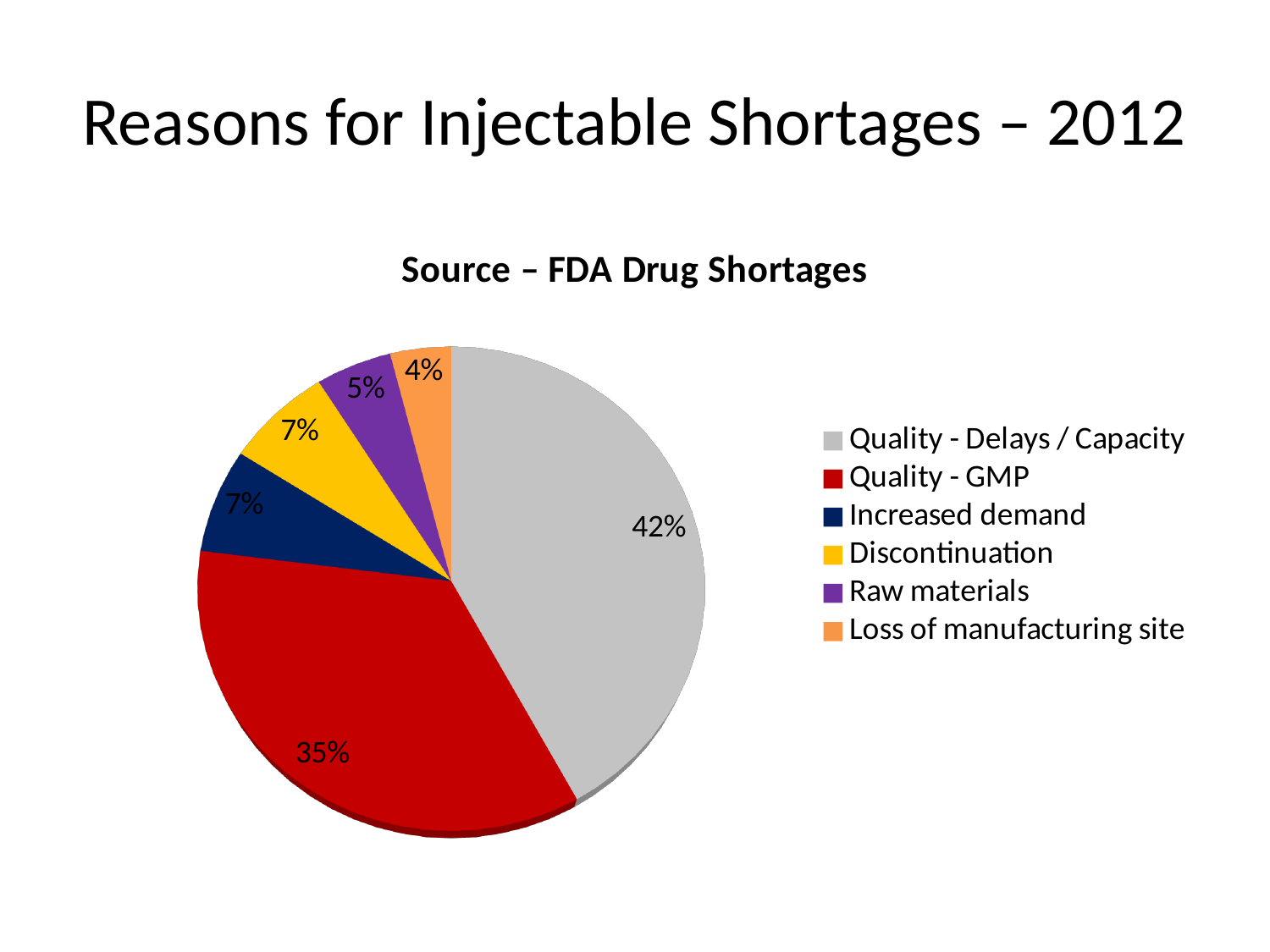
What share of the pie does Raw materials represent? 5% What share of the pie does Quality - Delays / Capacity represent? 42% What is the difference in percentage points between Quality - Delays / Capacity and Quality - GMP? 7 What is the title of the chart? Source – FDA Drug Shortages What colour is the slice for Increased demand? dark blue Which category has the smallest slice of the pie? Loss of manufacturing site Which is larger, the slice for Raw materials or the slice for Discontinuation? Discontinuation What share of the pie does Quality - GMP represent? 35% How many categories does the legend list? 6 Which category has the largest slice of the pie? Quality - Delays / Capacity What type of chart is shown on the slide? pie chart